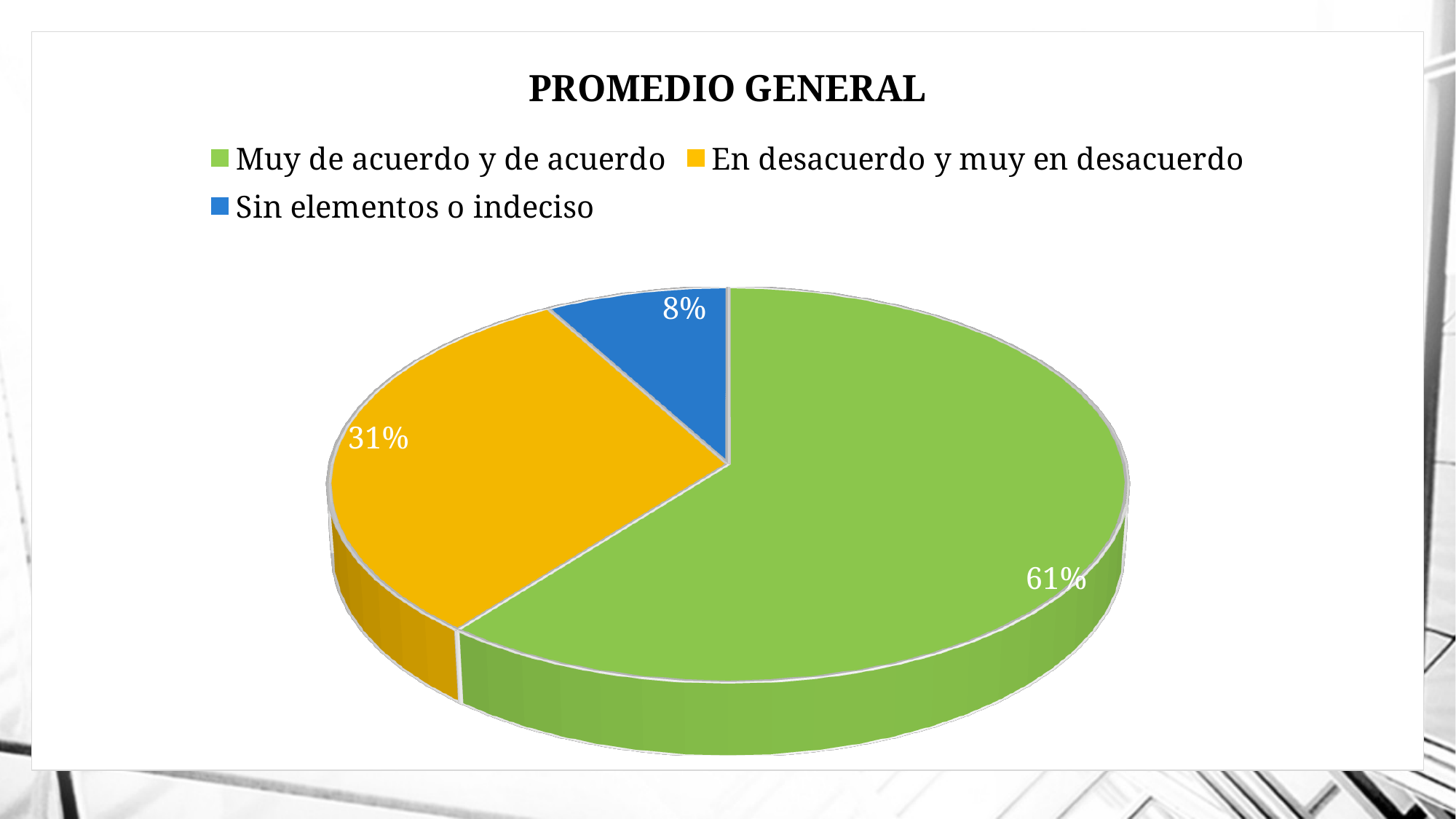
Which is larger: the slice for 'En desacuerdo y muy en desacuerdo' or the slice for 'Sin elementos o indeciso'? En desacuerdo y muy en desacuerdo What percentage is shown for 'En desacuerdo y muy en desacuerdo'? 31% What percentage is shown for 'Muy de acuerdo y de acuerdo'? 61% What is the title of the chart? PROMEDIO GENERAL What is the difference in percentage points between 'Muy de acuerdo y de acuerdo' and 'En desacuerdo y muy en desacuerdo'? 30 Which category has the largest slice of the pie? Muy de acuerdo y de acuerdo Which category has the smallest slice of the pie? Sin elementos o indeciso How many entries does the legend list? 3 How many slices does the pie chart have? 3 What type of chart is shown on the slide? Pie chart What percentage is shown for 'Sin elementos o indeciso'? 8% What colour is the slice for 'Sin elementos o indeciso'? Blue